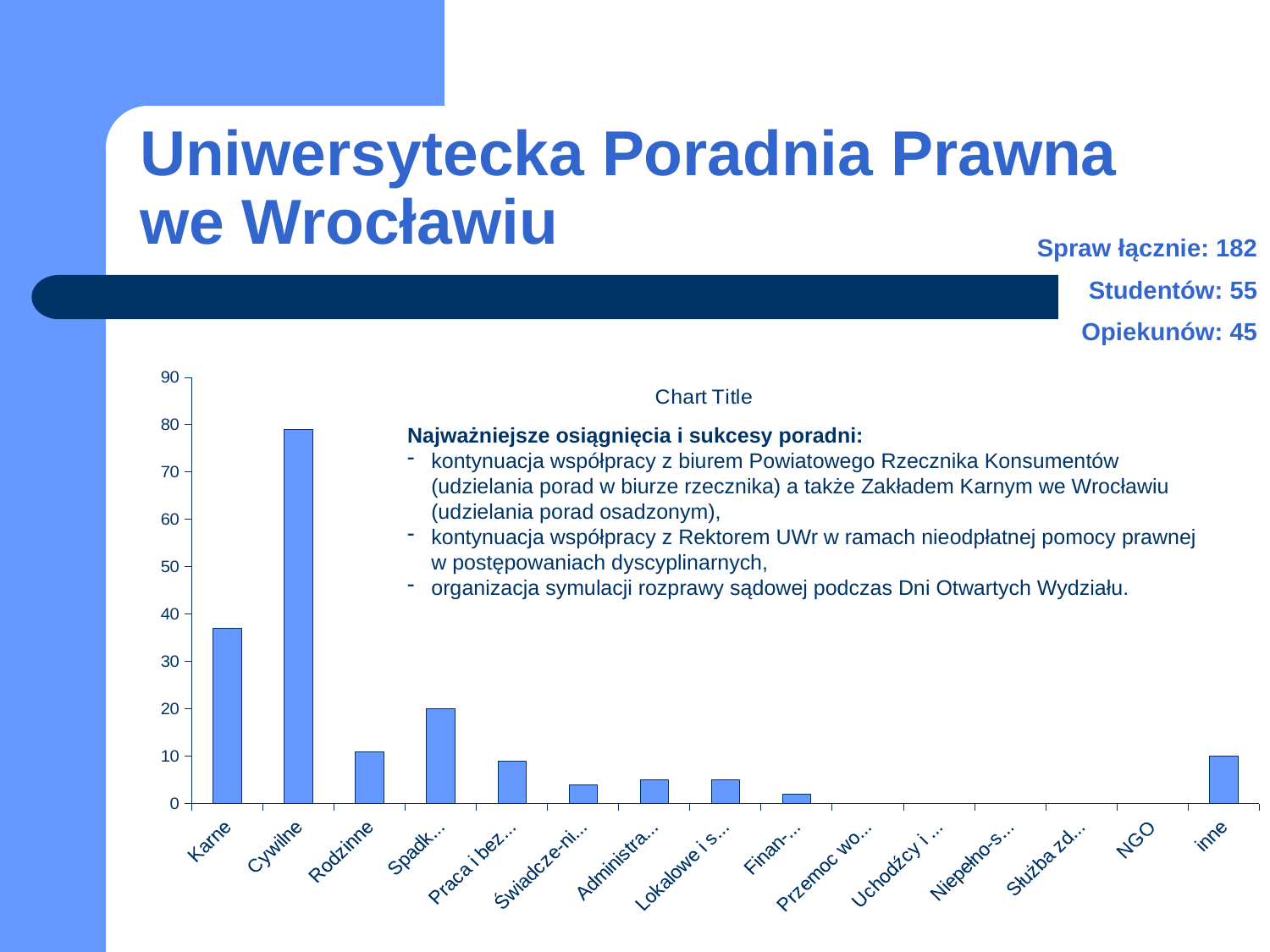
What kind of chart is shown on the slide? bar chart What is the highest value shown on the chart's vertical axis? 90 Is the value for Cywilne greater or less than 70? greater Which category has the highest bar in the chart? Cywilne What is the title shown on the chart? Chart Title How many categories are shown on the x axis of the chart? 15 Is the value for Karne greater or less than 40? less Is the value for Finan-... greater or less than 10? less Which is larger, the value for Karne or the value for Cywilne? Cywilne Which is larger, the value for Spadk... or the value for Rodzinne? Spadk...